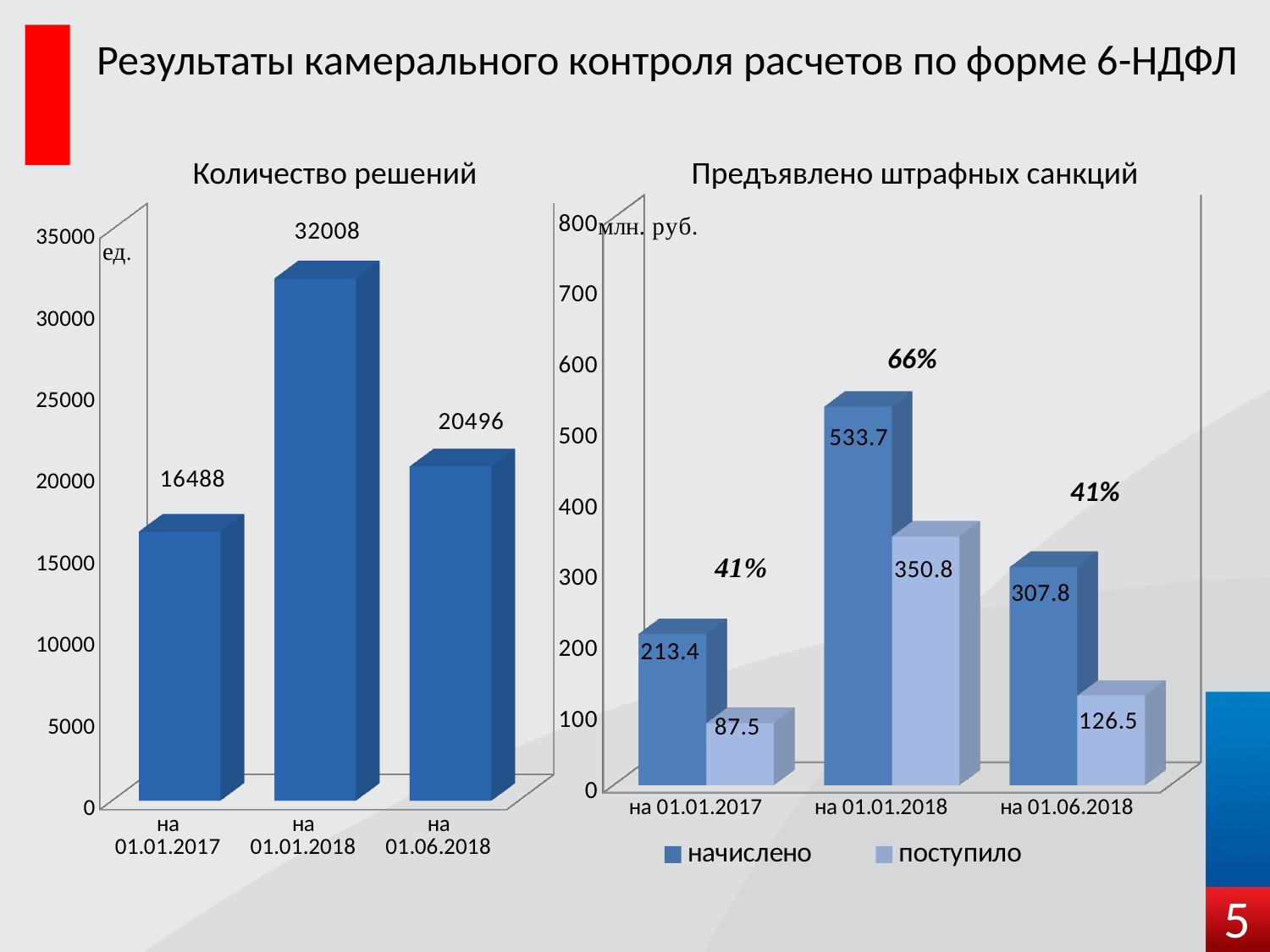
What kind of chart is the 'Количество решений' chart? bar chart In the 'Количество решений' chart, what is the difference between the values for на 01.01.2018 and на 01.06.2018? 11512 In the 'Количество решений' chart, how many categories are shown on the x axis? 3 In the 'Предъявлено штрафных санкций' chart, what percentage is shown above the bars for на 01.01.2018? 66% In the 'Количество решений' chart, which category has the lowest value? на 01.01.2017 In the 'Предъявлено штрафных санкций' chart, which is larger: 'поступило' for на 01.01.2018 or 'начислено' for на 01.06.2018? поступило for на 01.01.2018 In the 'Предъявлено штрафных санкций' chart, how many series does the legend list? 2 In the 'Предъявлено штрафных санкций' chart, what is the value of 'начислено' for на 01.01.2018? 533.7 In the 'Количество решений' chart, what is the value for на 01.01.2018? 32008 In the 'Предъявлено штрафных санкций' chart, which category has the highest 'начислено' value? на 01.01.2018 In the 'Предъявлено штрафных санкций' chart, what is the difference between 'начислено' and 'поступило' for на 01.01.2017? 125.9 In the 'Предъявлено штрафных санкций' chart, what is the value of 'поступило' for на 01.06.2018? 126.5